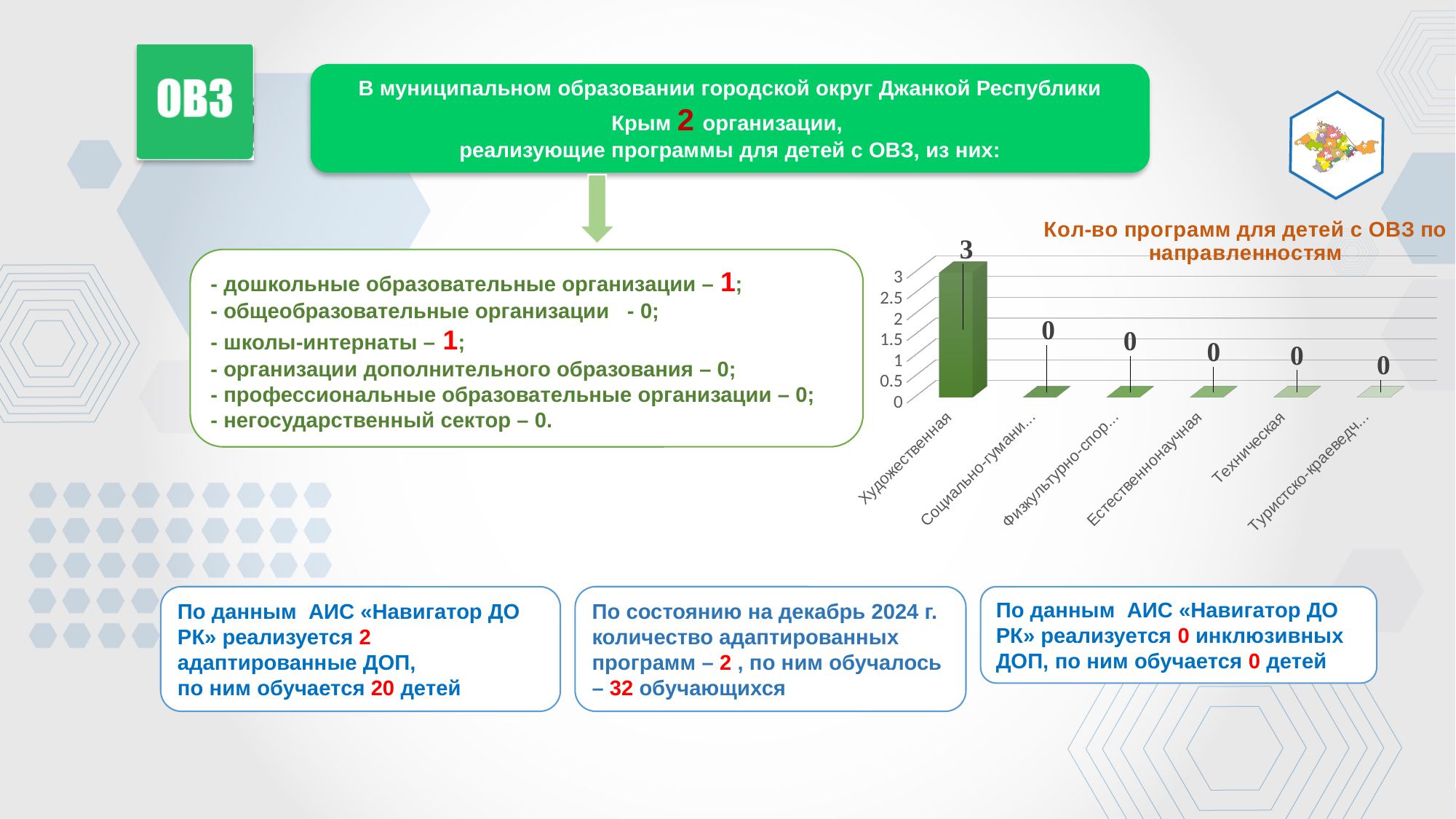
What is the difference between the values for Художественная and Техническая? 3 Which is larger, the value for Художественная or the value for Естественнонаучная? Художественная What is the value for Техническая in the chart? 0 Which category has the highest value in the chart? Художественная How many categories in the chart have a value of 0? 5 What is the value for Художественная in the chart? 3 What is the value for Естественнонаучная in the chart? 0 What is the highest tick value shown on the vertical axis of the chart? 3 How many categories are shown in the chart? 6 Is the value for Художественная greater or less than 2? greater What is the title of the chart? Кол-во программ для детей с ОВЗ по направленностям What kind of chart is shown on the slide? bar chart